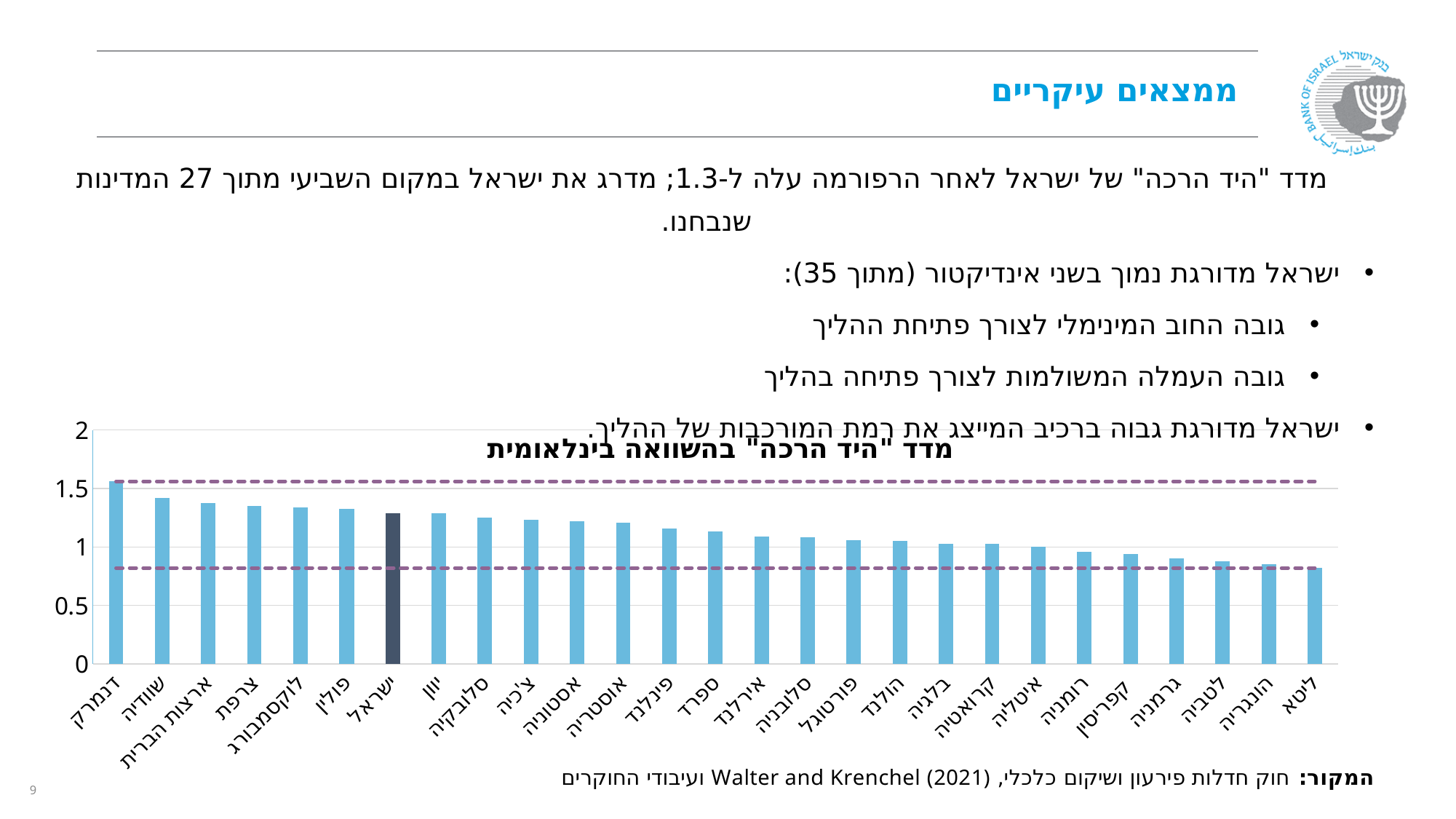
Which country has the highest value in the chart? דנמרק What kind of chart is shown on the slide? bar chart Do the bar values rise or fall moving from left to right along the x axis? fall Which has the larger value, שוודיה or ספרד? שוודיה Is the value for ליטא greater or less than 1? less Is the value for גרמניה greater or less than 1? less Is the value for דנמרק greater or less than 1.5? greater Which country has the lowest value in the chart? ליטא How many countries (bars) are shown in the chart? 27 Which country's bar is drawn in a dark colour, different from the other bars? ישראל What is the title of the chart? מדד "היד הרכה" בהשוואה בינלאומית